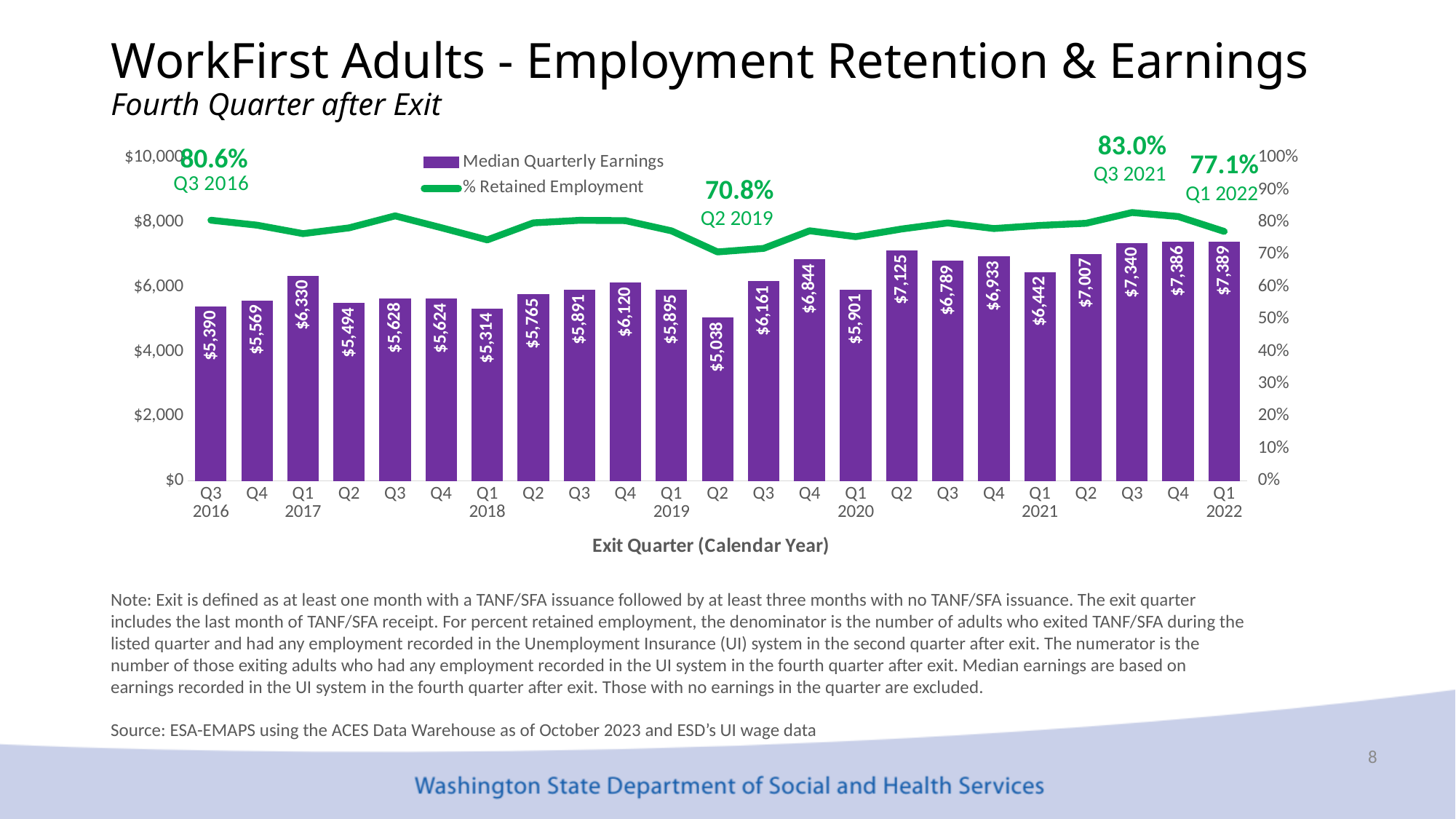
What kind of chart is shown on the slide? Combined bar and line chart What is the median quarterly earnings value for Q1 2022? $7,389 What is the median quarterly earnings value for Q4 2019? $6,844 Is the % retained employment for Q1 2018 greater or less than 80%? less Which exit quarter has the lowest median quarterly earnings? Q2 2019 How many exit quarters are shown on the x axis? 23 Which has higher median quarterly earnings, Q1 2017 or Q2 2017? Q1 2017 What is the difference in median quarterly earnings between Q1 2022 and Q3 2016? $1,999 What is the difference between the labeled % retained employment for Q3 2021 and Q2 2019? 12.2 percentage points How many series does the legend list? 2 What percent retained employment is labeled for Q3 2021? 83.0% Which exit quarter has the lowest labeled % retained employment? Q2 2019